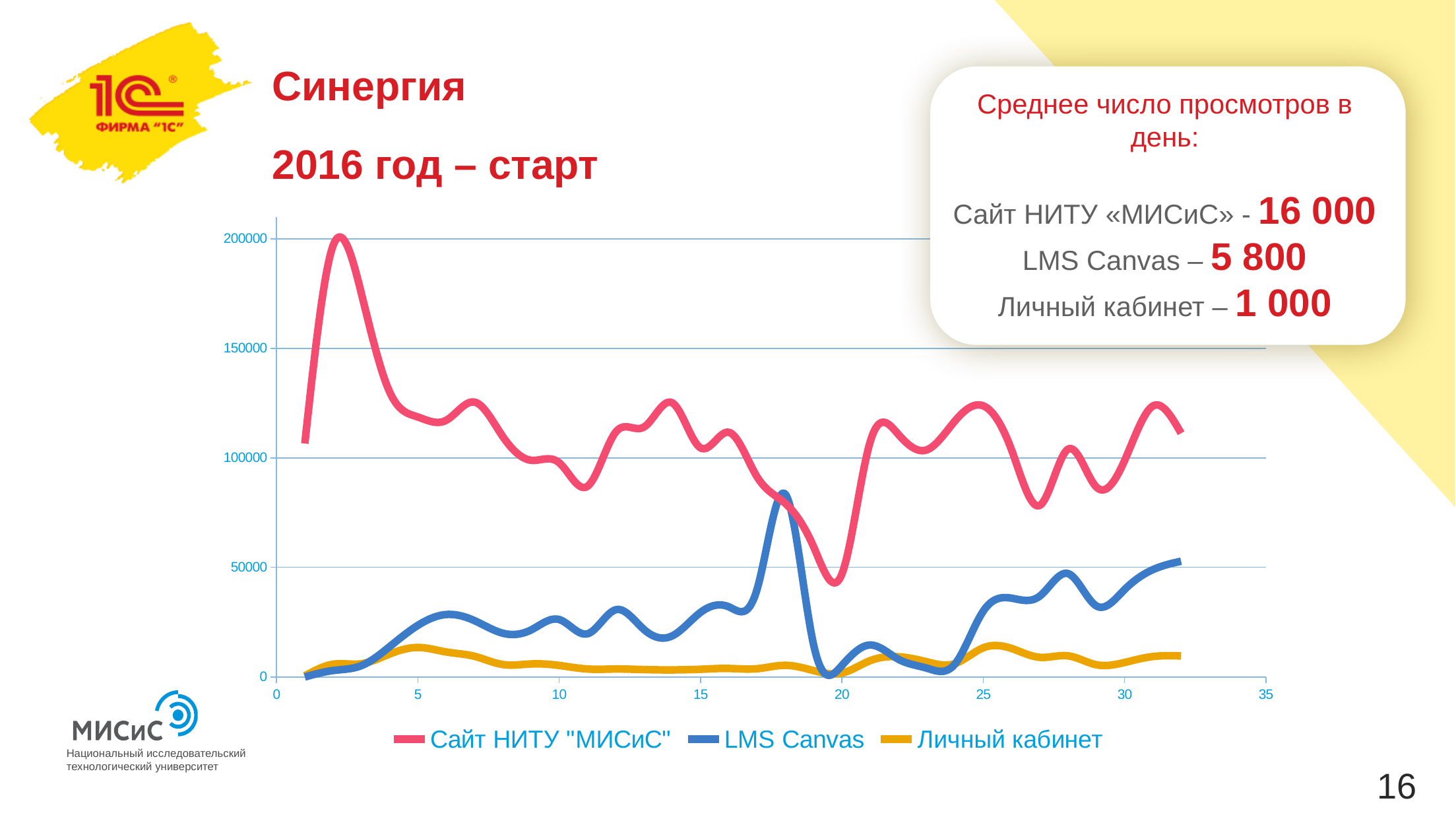
At x = 30, which series has the larger value: LMS Canvas or Личный кабинет? LMS Canvas What colour is the line for the LMS Canvas series? blue What kind of chart is shown on the slide? line chart How many series does the chart legend list? 3 Is the value of the Личный кабинет series at x = 25 greater or less than 50000? less Is the peak value of the Сайт НИТУ "МИСиС" series greater or less than 150000? greater Is the peak value of the LMS Canvas series (around x = 18) greater or less than 50000? greater At x = 5, which series has the larger value: Сайт НИТУ "МИСиС" or LMS Canvas? Сайт НИТУ "МИСиС" Which series has the highest values across the chart? Сайт НИТУ "МИСиС" Which series has the lowest values across the chart? Личный кабинет What is the highest value shown on the vertical axis of the chart? 200000